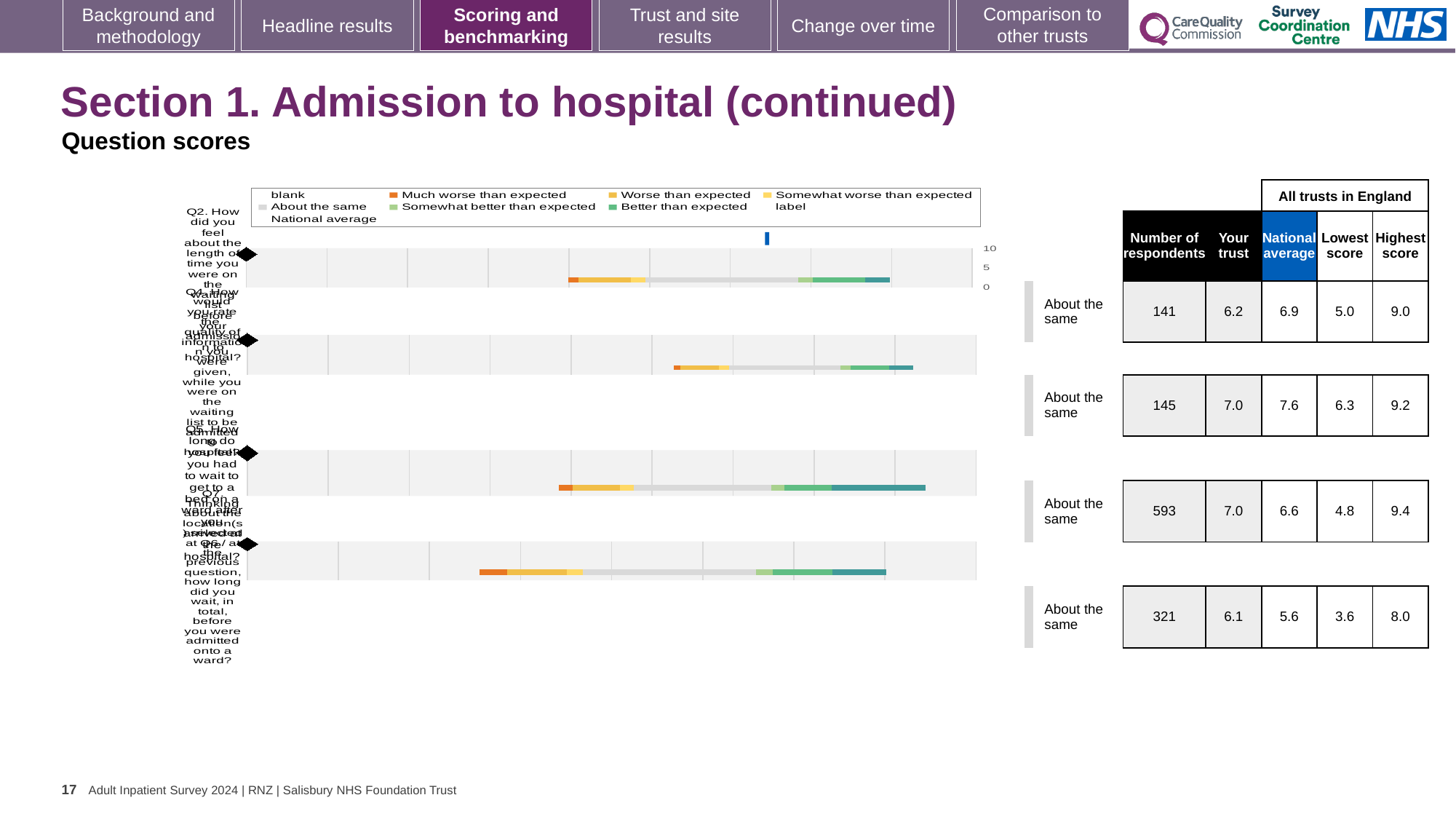
In the table beside the chart, what is the 'Your trust' score for the fourth row (Q7)? 6.1 Which row in the table has the largest number of respondents? Third row (Q5), 593 How many entries does the chart legend list? 9 Which row in the table has the lowest 'Lowest score' value? Fourth row (Q7), 3.6 In the table beside the chart, what is the national average for the third row (Q5)? 6.6 For the second row (Q4), which is larger: the 'Your trust' score or the national average? National average In the table beside the chart, what is the number of respondents for the first row (Q2)? 141 What kind of chart is shown on the slide? bar chart In the table beside the chart, what is the highest score for the second row (Q4)? 9.2 How many question rows (bars) are plotted in the chart? 4 What benchmark category is shown next to every row of the chart? About the same For the first row (Q2), what is the difference between the national average and the 'Your trust' score? 0.7